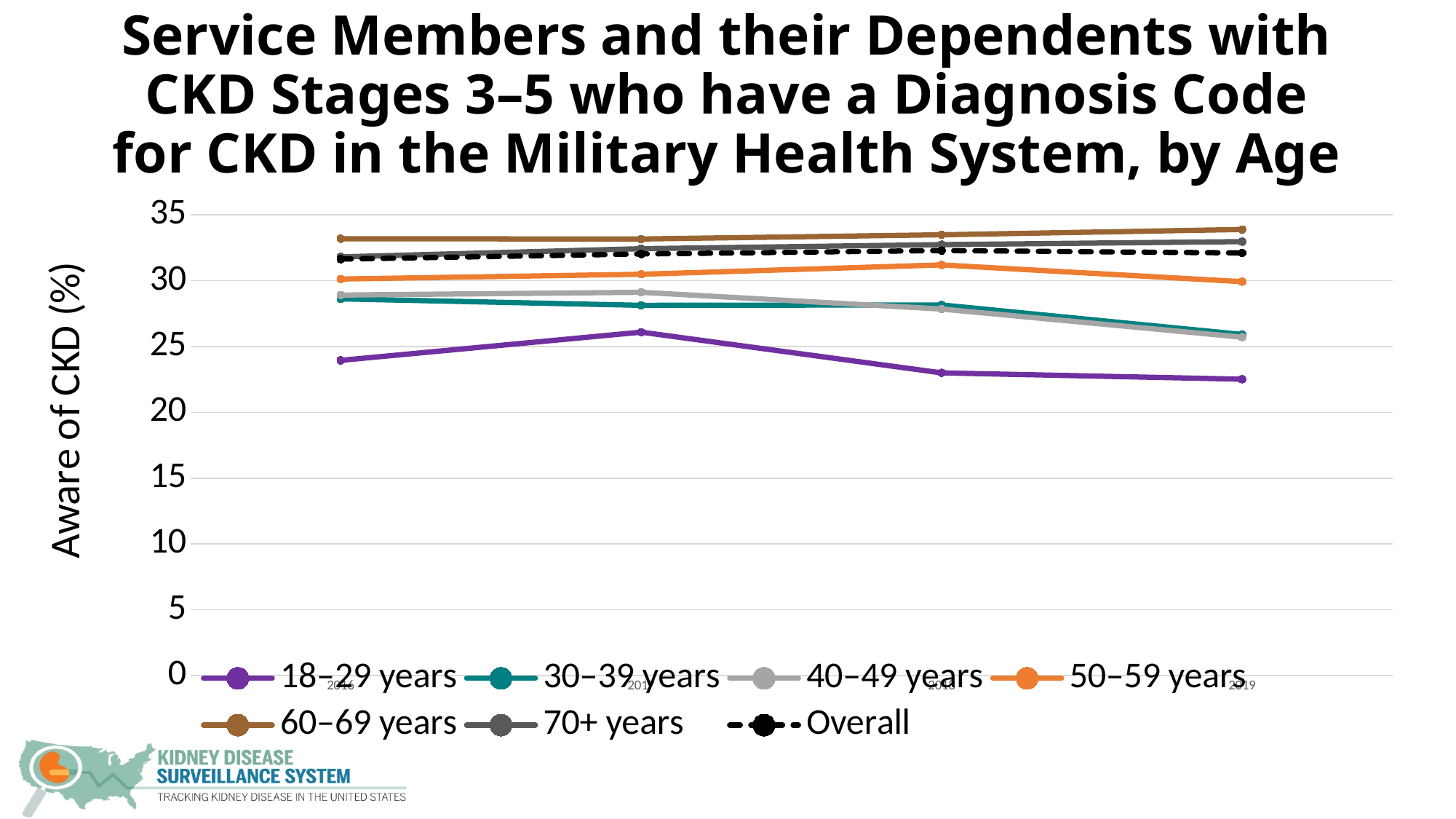
At the rightmost point, which is larger: 70+ years or 40–49 years? 70+ years Is the value for 40–49 years at the rightmost point greater or less than 30? less How many series does the legend list? 7 How many data points does each line have? 4 Does the 40–49 years line rise or fall from its first point to its last point? Fall Which legend entry is drawn as a dashed line? Overall What is the label on the vertical axis? Aware of CKD (%) Is the value for 60–69 years at the leftmost point greater or less than 30? greater What kind of chart is shown on the slide? Line chart Which age group has the highest values across the chart? 60–69 years Which age group has the lowest values across the chart? 18–29 years Is the value for 18–29 years at the rightmost point greater or less than 25? less